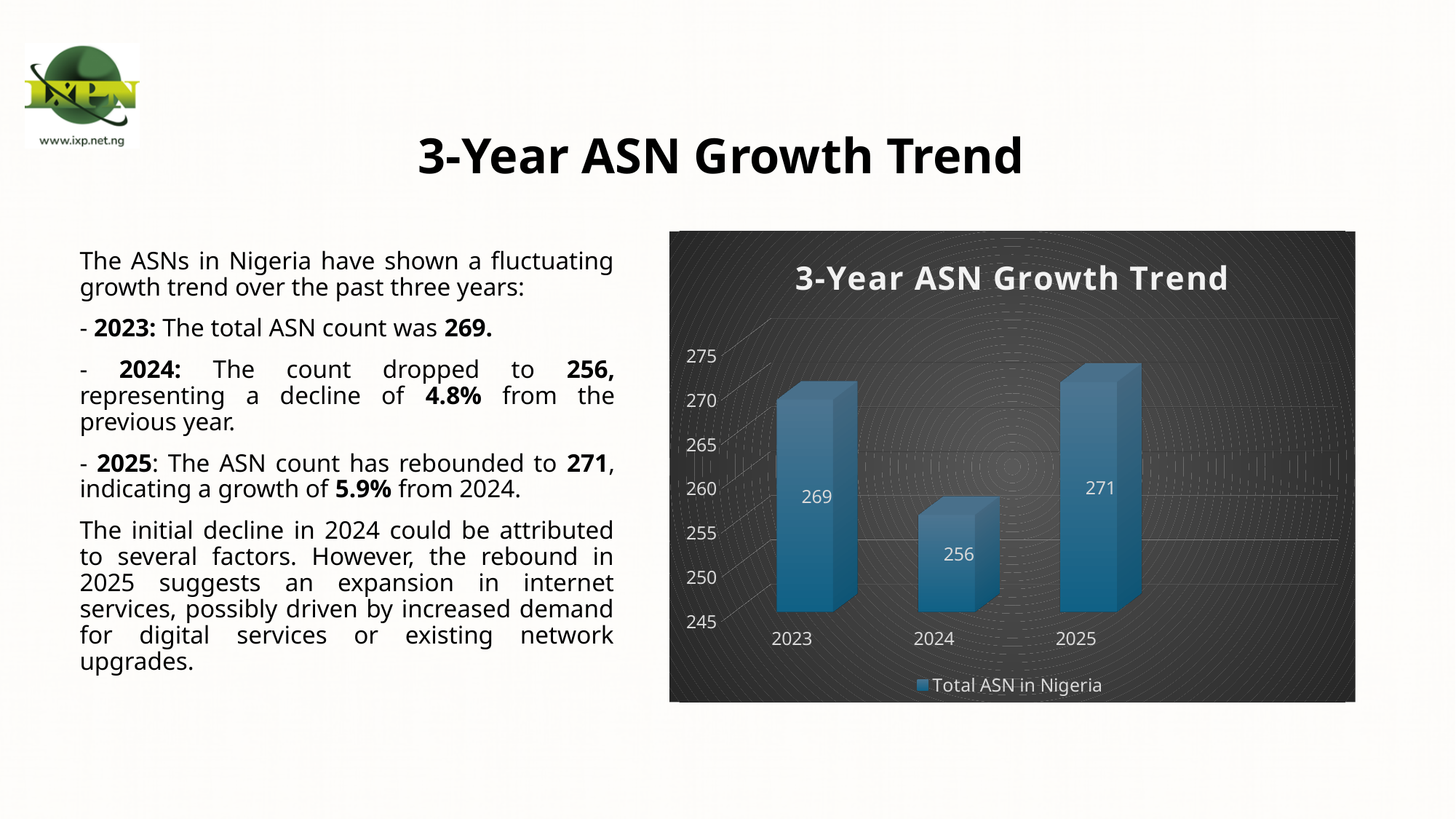
How many series does the chart legend list? 1 What is the difference between the values for 2023 and 2024? 13 What is the value for 2023 in the chart? 269 Which year has the highest Total ASN in Nigeria? 2025 What is the value for 2025 in the chart? 271 Which year has the lowest Total ASN in Nigeria? 2024 Which is larger, the value for 2023 or the value for 2024? 2023 What kind of chart is shown on the slide? bar chart Is the value for 2024 greater or less than 260? less What is the value for 2024 in the chart? 256 What is the difference between the values for 2025 and 2024? 15 How many years are shown on the x axis of the chart? 3